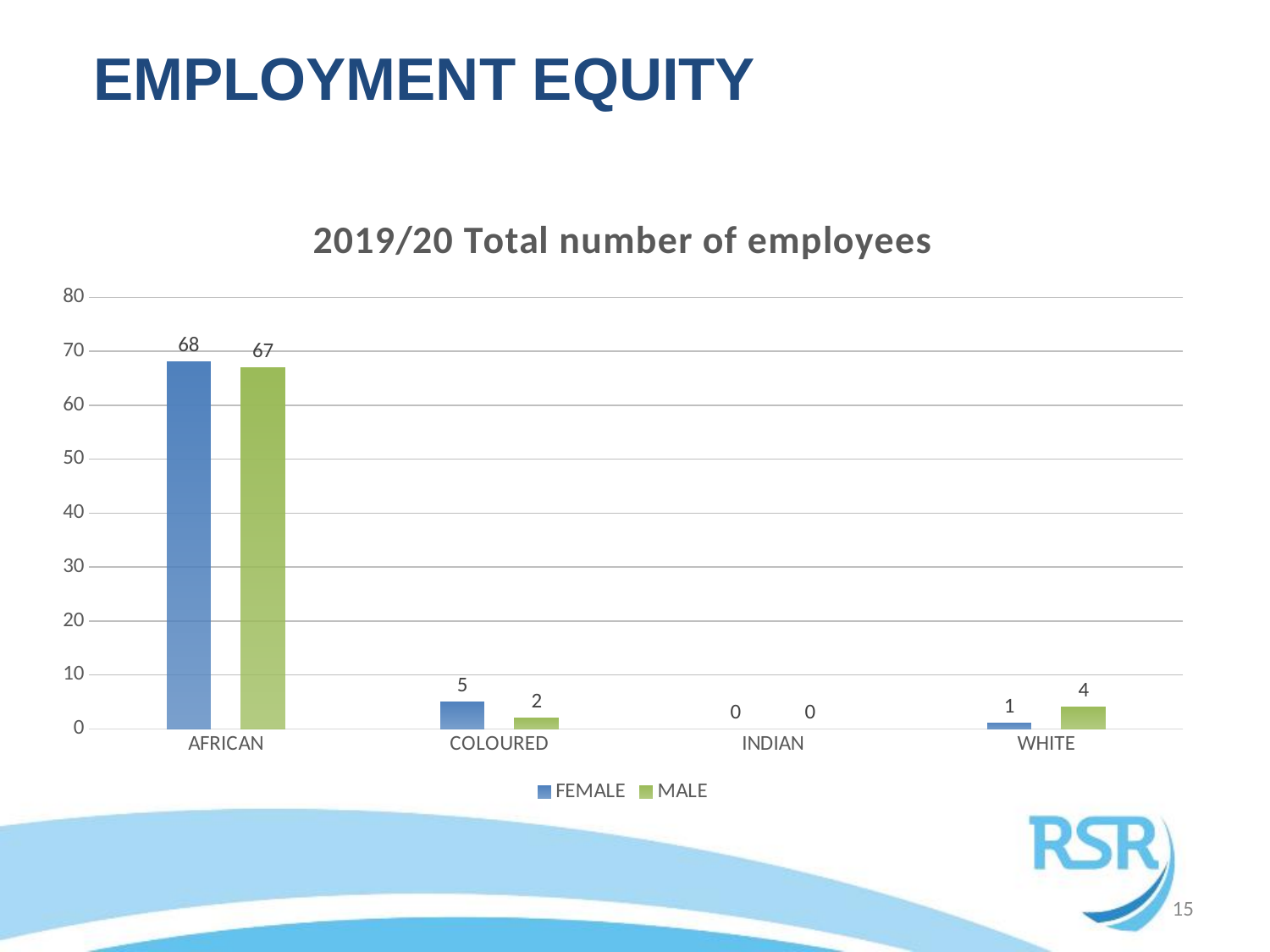
What is the number of male employees in the COLOURED category? 2 What is the number of female employees in the AFRICAN category? 68 Which category has the lowest number of male employees? INDIAN Which is larger in the WHITE category, the number of female employees or the number of male employees? MALE What is the title of the chart? 2019/20 Total number of employees Is the value for AFRICAN male employees greater or less than 60? greater How many categories are shown on the x axis? 4 Which category has the highest number of female employees? AFRICAN What kind of chart is shown on the slide? Bar chart What is the difference between the number of female and male employees in the AFRICAN category? 1 What is the number of male employees in the WHITE category? 4 How many series does the legend list? 2